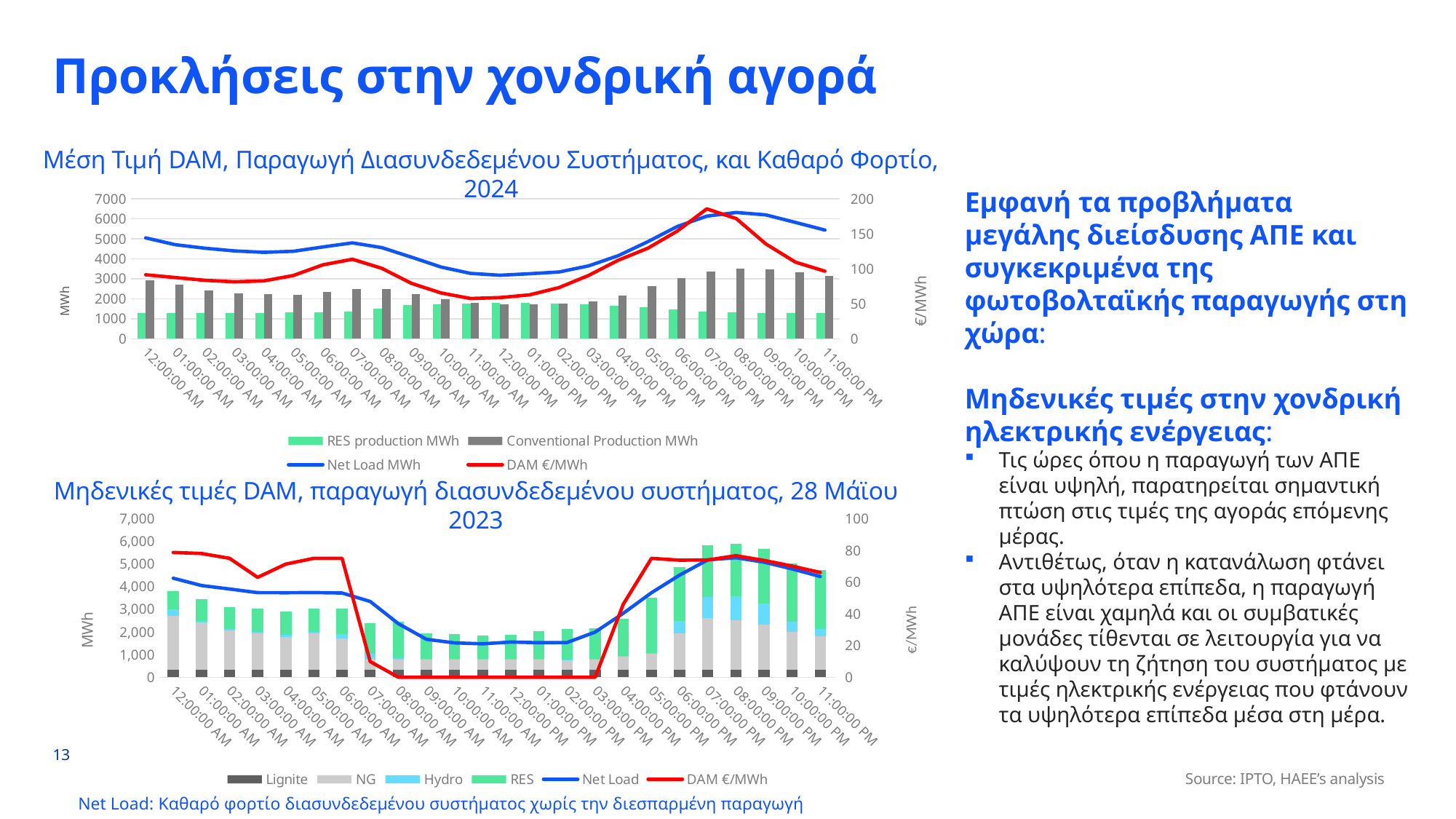
In the bottom chart (28 Μαΐου 2023), is the Net Load value at 12:00:00 AM greater or less than 4,000? greater What unit is shown on the right-hand axis of the bottom chart (28 Μαΐου 2023)? €/MWh How many series does the legend of the top chart (2024) list? 4 In the top chart (2024), at 12:00:00 AM, which is larger: RES production MWh or Conventional Production MWh? Conventional Production MWh What type of chart is the top chart titled 'Μέση Τιμή DAM, Παραγωγή Διασυνδεδεμένου Συστήματος, και Καθαρό Φορτίο, 2024'? Combined bar and line chart How many series does the legend of the bottom chart (28 Μαΐου 2023) list? 6 In the top chart (2024), does the DAM €/MWh line rise or fall between 11:00:00 AM and 07:00:00 PM? Rise In the bottom chart (28 Μαΐου 2023), which is larger: the DAM €/MWh value at 12:00:00 AM or at 10:00:00 AM? 12:00:00 AM How many hourly categories are shown on the x axis of the bottom chart (28 Μαΐου 2023)? 24 In the top chart (2024), is the Net Load MWh value at 11:00:00 AM greater or less than 4000? less In the top chart (2024), is the DAM €/MWh value at 07:00:00 PM greater or less than 150? greater In the top chart (2024), at which hour does the DAM €/MWh line reach its highest value? 07:00:00 PM